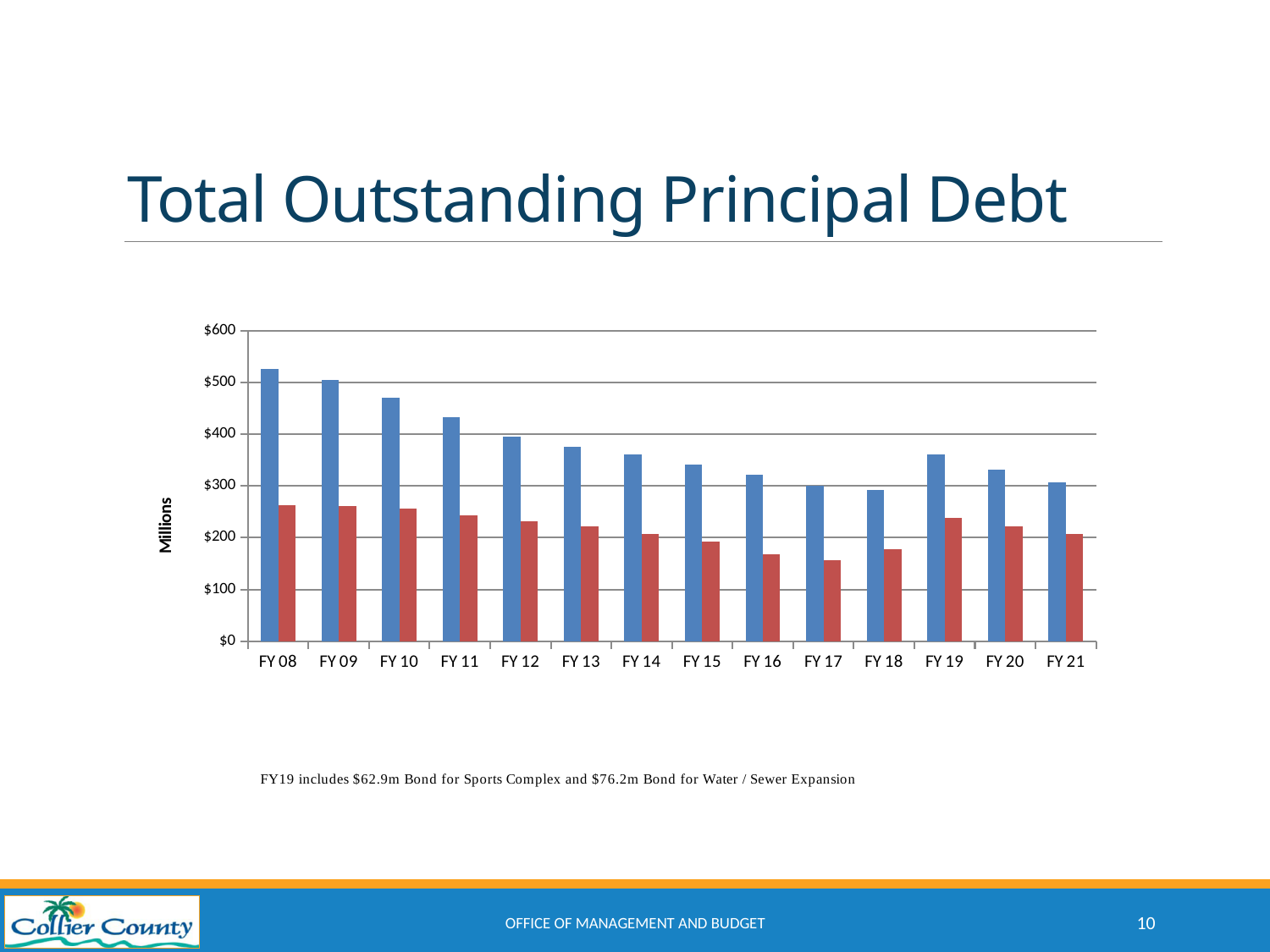
Is the blue bar for FY 08 greater or less than $500? greater What is the title of the chart? Total Outstanding Principal Debt How many fiscal years are shown on the x axis of the chart? 14 Is the red bar for FY 17 greater or less than $200? less How many bars are plotted for each fiscal year? 2 Is the red bar for FY 08 greater or less than $200? greater What kind of chart is shown on the slide? bar chart In FY 08, which bar is larger, the blue bar or the red bar? the blue bar In which fiscal year is the blue bar the highest? FY 08 What is the label on the vertical axis of the chart? Millions Do the blue bars rise or fall from FY 08 to FY 18? fall